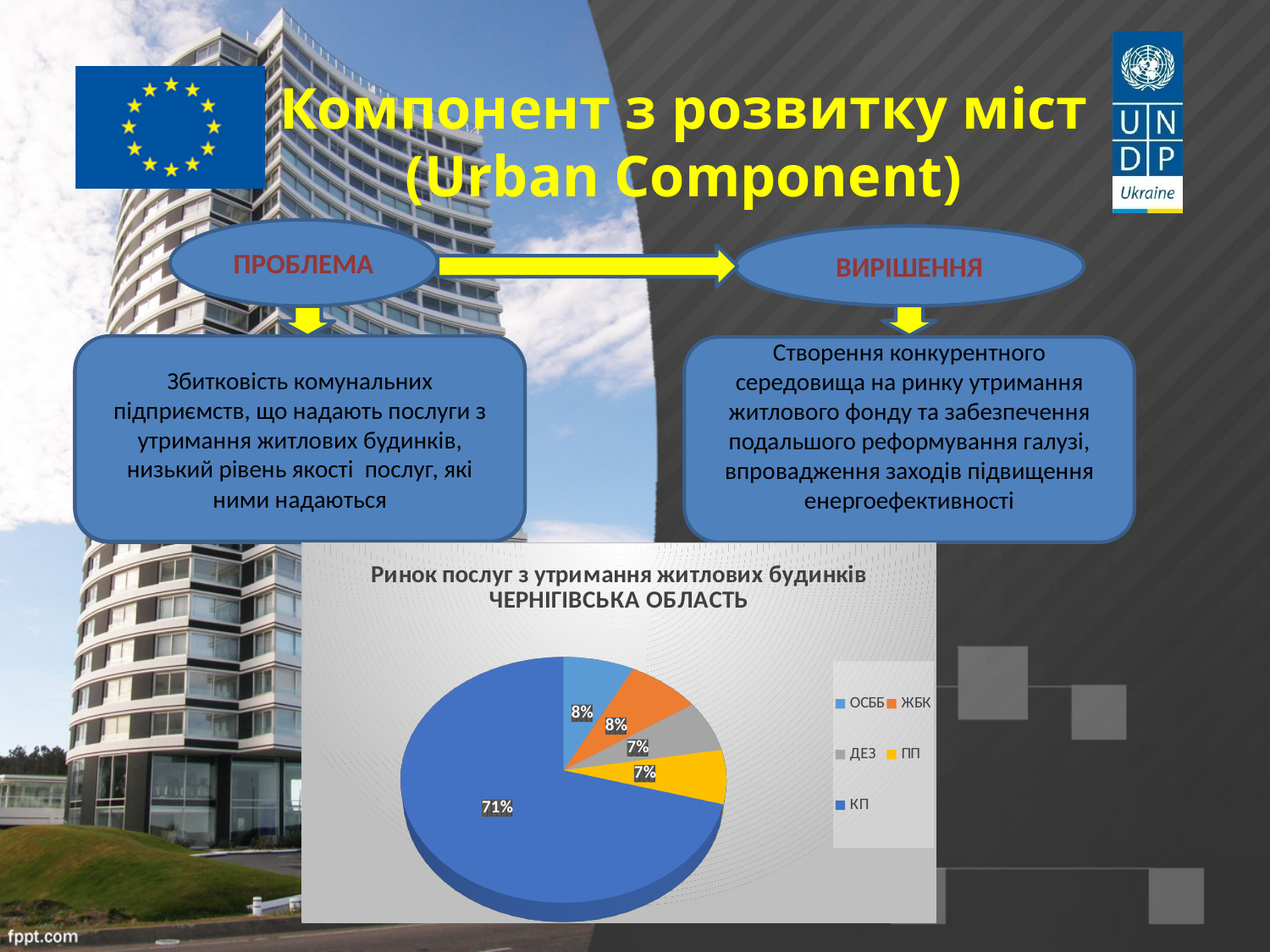
What is the value shown for ОСББ? 8% How many entries does the legend list? 5 What share of the pie does КП hold? 71% What kind of chart is shown on the slide? Pie chart Which is larger, the slice for ОСББ or the slice for ПП? ОСББ What is the difference between the КП slice and the ОСББ slice? 63% What is the value shown for ДЕЗ? 7% Which is larger, the slice for КП or the slice for ЖБК? КП Which category has the largest slice of the pie? КП How many slices does the pie chart have? 5 Which region is named in the chart title? ЧЕРНІГІВСЬКА ОБЛАСТЬ What is the value shown for ЖБК? 8%